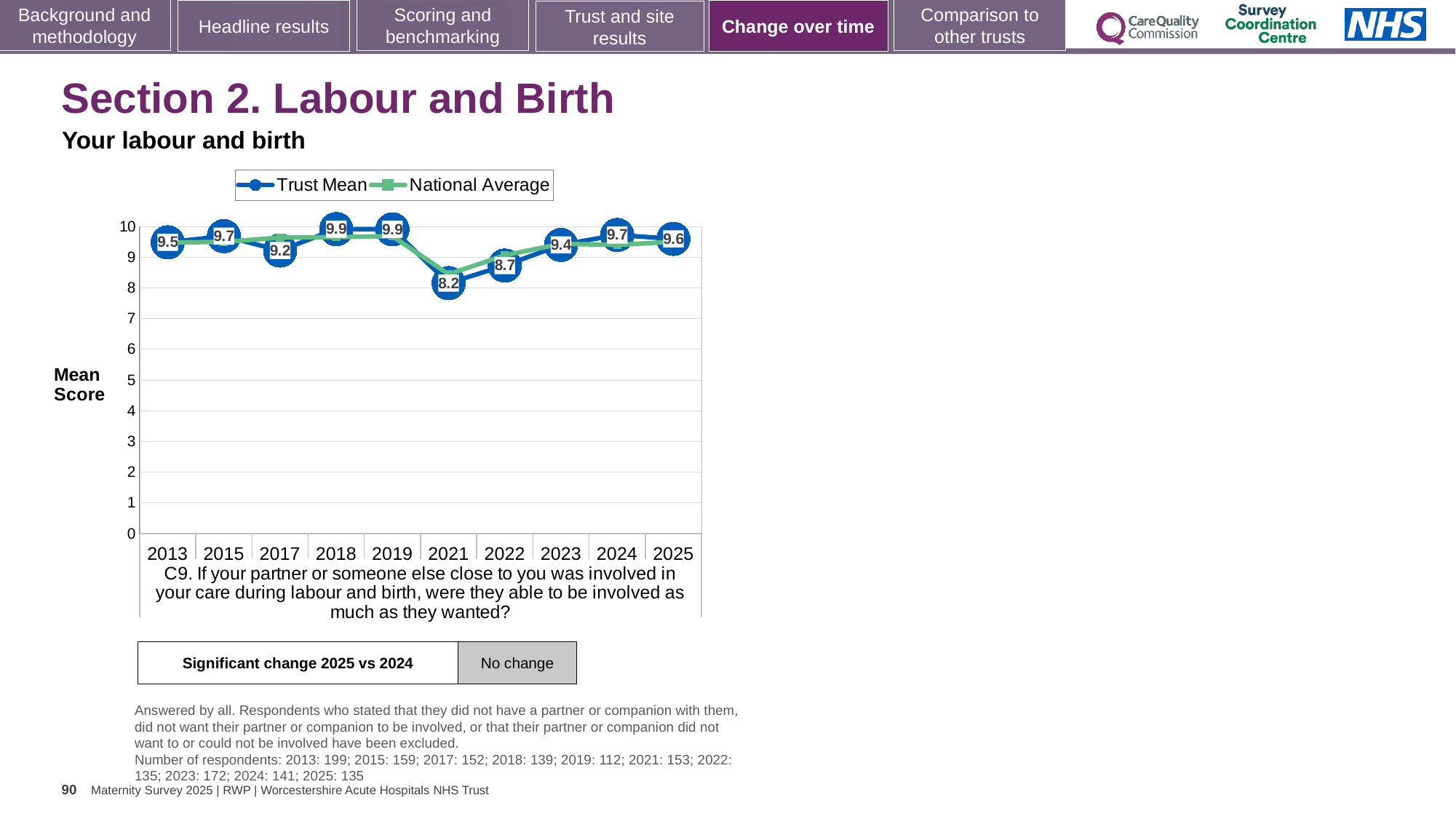
Which year has the larger Trust Mean score, 2017 or 2018? 2018 In which year is the Trust Mean score lowest? 2021 What is the highest Trust Mean score shown on the chart? 9.9 What is the Trust Mean score for 2013? 9.5 How many survey years are plotted on the x axis? 10 What kind of chart is shown on the slide? line chart What is the difference between the Trust Mean scores for 2019 and 2021? 1.7 Is the National Average value for 2021 greater or less than 9? less What is the Trust Mean score for 2025? 9.6 Does the Trust Mean score rise or fall between 2021 and 2024? rise What is the Trust Mean score for 2021? 8.2 How many series does the legend list? 2